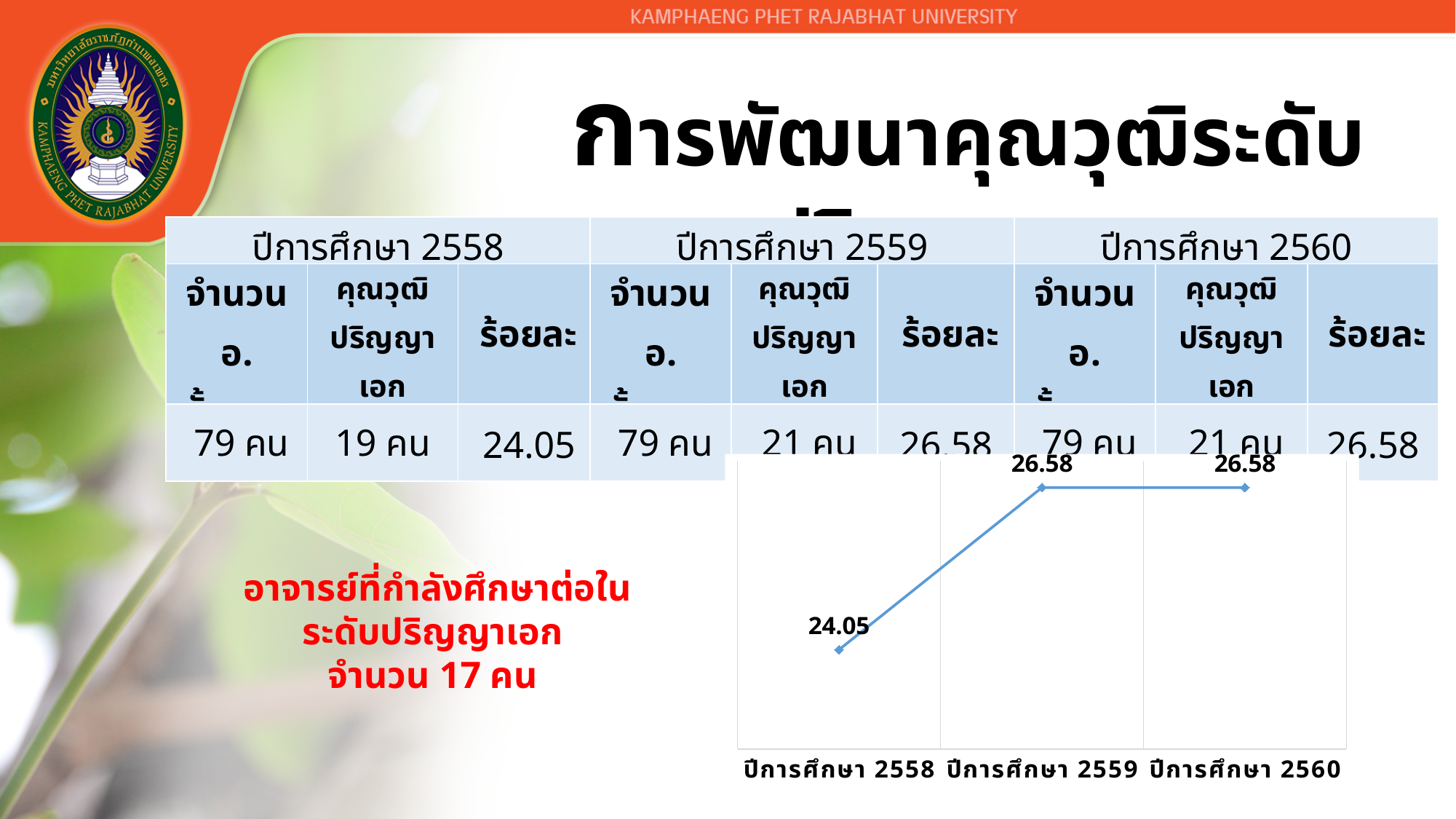
Which is larger in the line chart, the value for ปีการศึกษา 2558 or the value for ปีการศึกษา 2559? ปีการศึกษา 2559 How many data points are plotted in the line chart? 3 What kind of chart is shown on the slide? line chart What is the value plotted for ปีการศึกษา 2559 in the line chart? 26.58 What is the difference between the values for ปีการศึกษา 2560 and ปีการศึกษา 2559 in the line chart? 0 What is the difference between the values for ปีการศึกษา 2559 and ปีการศึกษา 2558 in the line chart? 2.53 What is the value plotted for ปีการศึกษา 2560 in the line chart? 26.58 Which academic year has the lowest value in the line chart? ปีการศึกษา 2558 Does the plotted value change between ปีการศึกษา 2559 and ปีการศึกษา 2560? No, it stays at 26.58 What is the value plotted for ปีการศึกษา 2558 in the line chart? 24.05 What are the three category labels on the x axis of the line chart? ปีการศึกษา 2558, ปีการศึกษา 2559, ปีการศึกษา 2560 Does the plotted value rise or fall from ปีการศึกษา 2558 to ปีการศึกษา 2559? rise